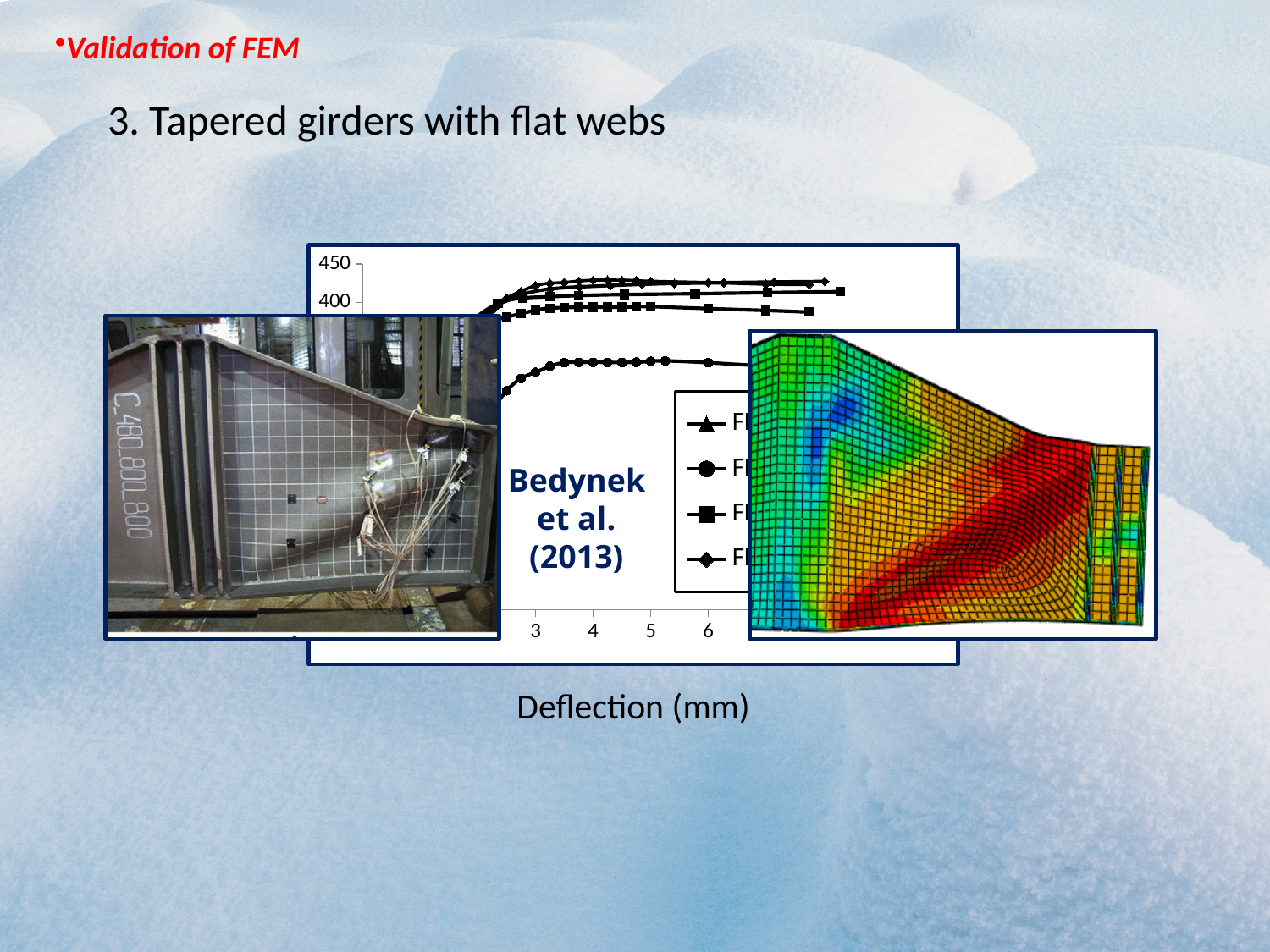
Do the plotted series rise or fall as deflection increases from 3 mm to 4 mm? rise Which reference is cited on the chart for the test data? Bedynek et al. (2013) What kind of chart is shown on the slide? line chart Is the peak value of the series with diamond markers greater or less than 400? greater Is the peak value of the series with diamond markers greater or less than 450? less Is the peak value of the series with circle markers greater or less than 400? less What is the label of the x axis of the chart? Deflection (mm)